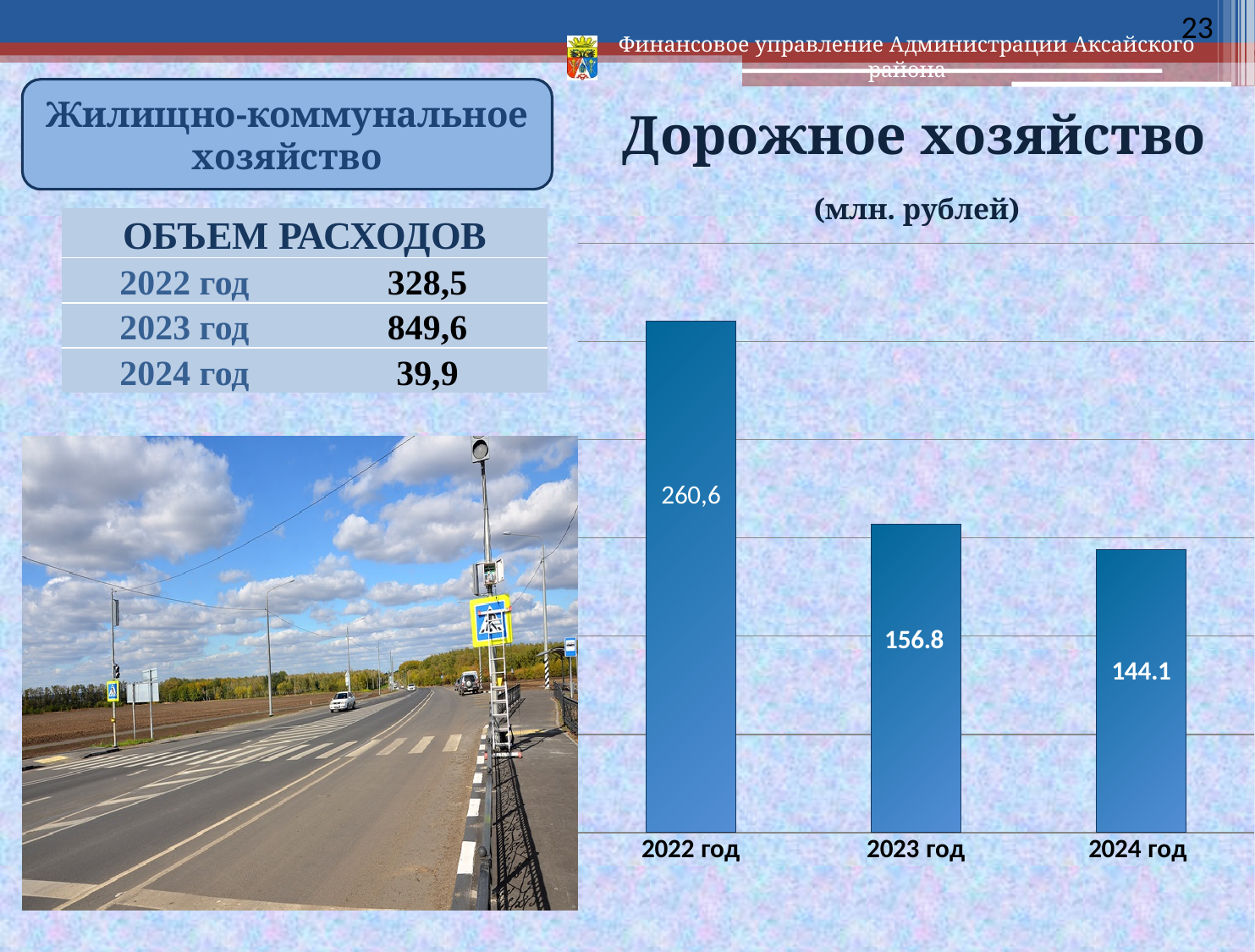
Do the values in the Дорожное хозяйство chart rise or fall from 2022 год to 2024 год? fall What is the value for 2024 год in the Дорожное хозяйство chart? 144.1 What is the value for 2022 год in the Дорожное хозяйство chart? 260,6 In the Дорожное хозяйство chart, what is the difference between the values for 2023 год and 2024 год? 12.7 How many bars are shown in the Дорожное хозяйство chart? 3 What is the value for 2023 год in the Дорожное хозяйство chart? 156.8 In the Дорожное хозяйство chart, which is larger: the value for 2022 год or the value for 2023 год? 2022 год What unit is stated under the title of the Дорожное хозяйство chart? млн. рублей In the Дорожное хозяйство chart, what is the difference between the values for 2022 год and 2023 год? 103.8 Which year has the highest value in the Дорожное хозяйство chart? 2022 год What type of chart is the Дорожное хозяйство chart? bar chart Which year has the lowest value in the Дорожное хозяйство chart? 2024 год